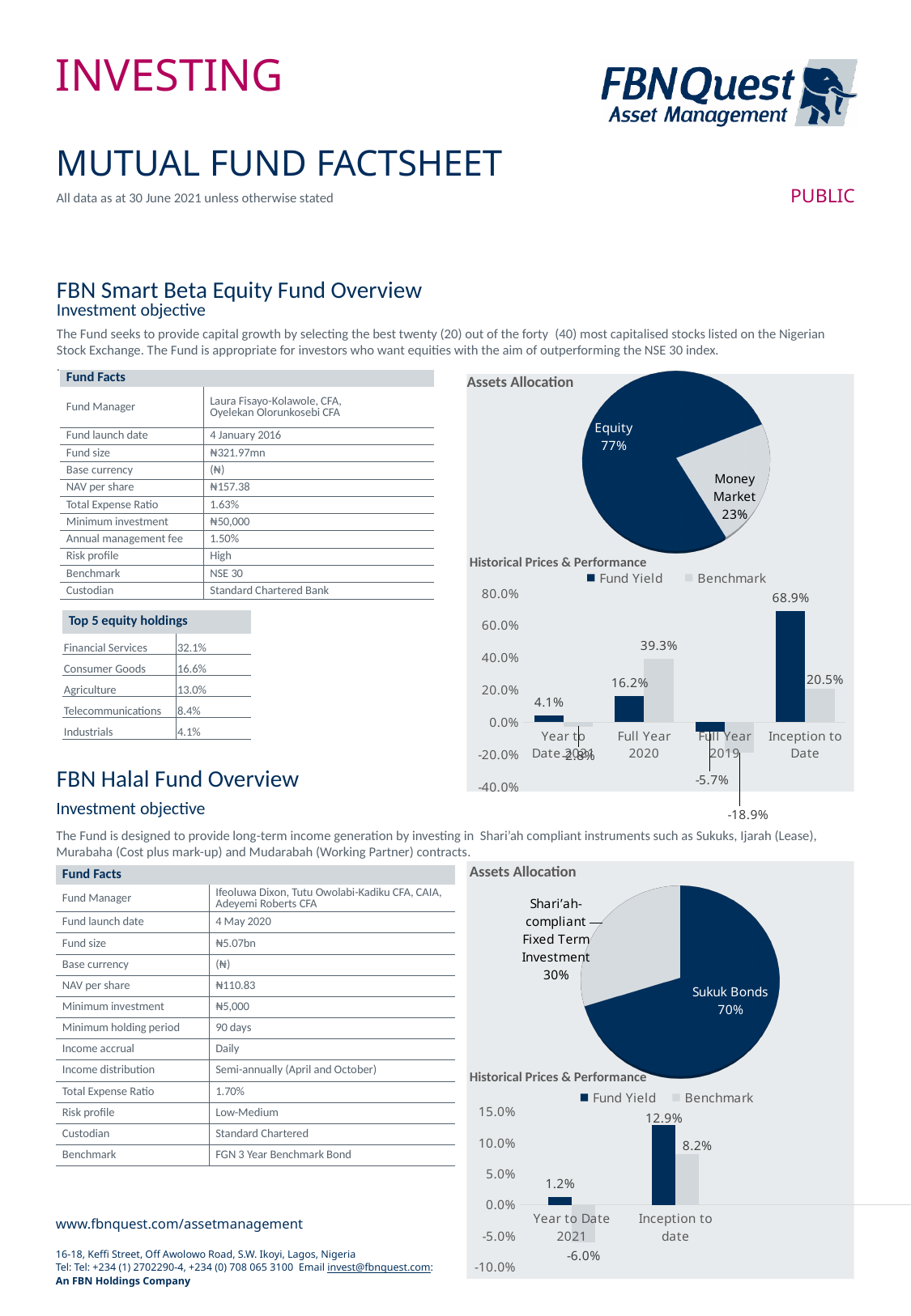
In the Historical Prices & Performance chart for the FBN Halal Fund, what is the Benchmark value for Year to Date 2021? -6.0% In the Historical Prices & Performance chart for the FBN Smart Beta Equity Fund, which period has the lowest Benchmark value? Full Year 2019 What kind of chart is the Historical Prices & Performance chart for the FBN Halal Fund? Bar chart In the Historical Prices & Performance chart for the FBN Smart Beta Equity Fund, what is the difference between the Fund Yield and the Benchmark for Full Year 2020? 23.1% In the Historical Prices & Performance chart for the FBN Smart Beta Equity Fund, how many series does the legend list? 2 In the Assets Allocation pie chart for the FBN Halal Fund, what share is Sukuk Bonds? 70% In the Historical Prices & Performance chart for the FBN Halal Fund, which is larger for Inception to date, the Fund Yield or the Benchmark? Fund Yield In the Historical Prices & Performance chart for the FBN Smart Beta Equity Fund, what is the Benchmark value for Full Year 2020? 39.3% In the Assets Allocation pie chart for the FBN Smart Beta Equity Fund, what share is Money Market? 23% In the Assets Allocation pie chart for the FBN Smart Beta Equity Fund, what share is Equity? 77% In the Historical Prices & Performance chart for the FBN Smart Beta Equity Fund, how many periods are shown on the x axis? 4 In the Historical Prices & Performance chart for the FBN Smart Beta Equity Fund, what is the Fund Yield for Inception to Date? 68.9%